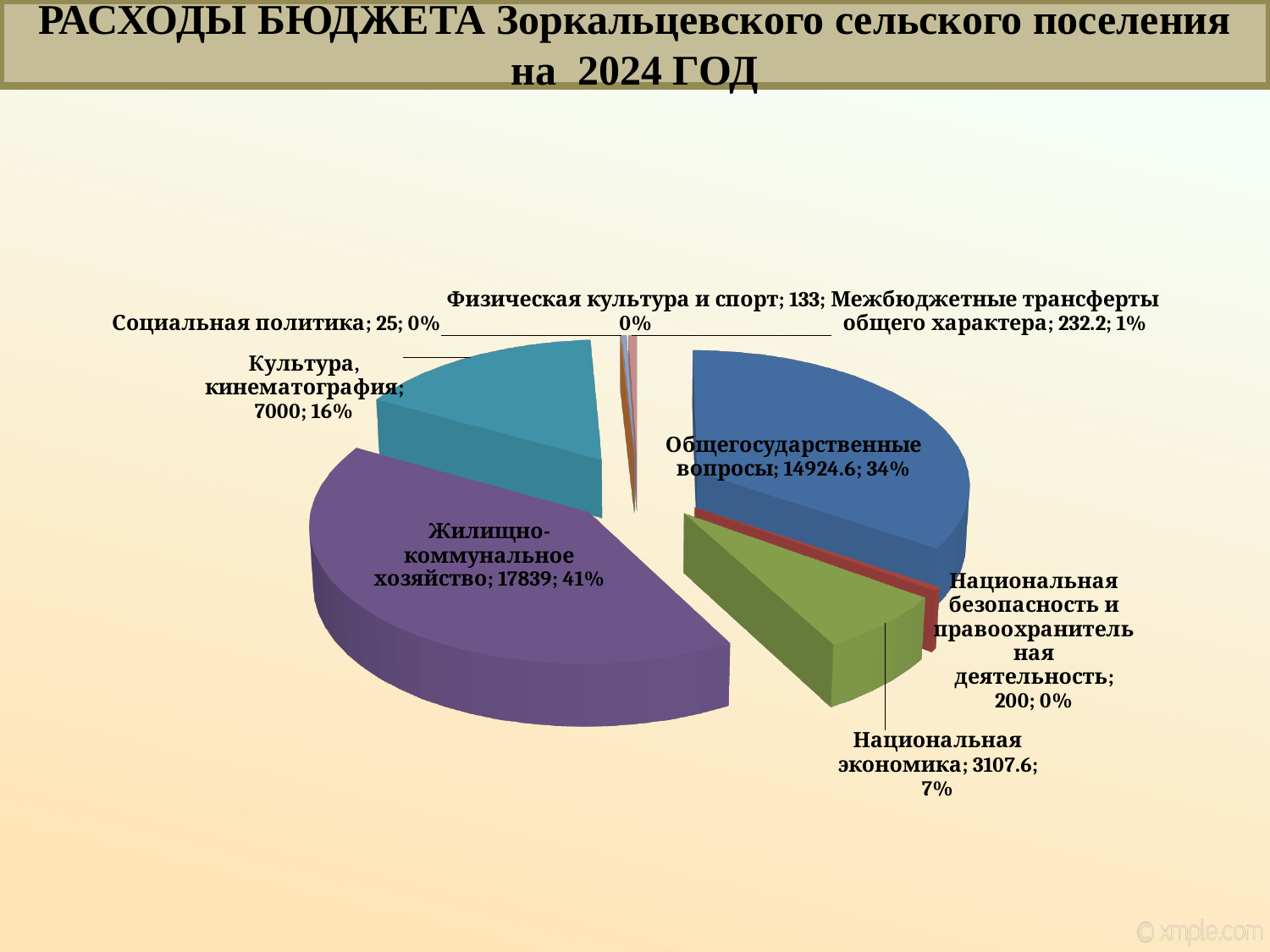
What is the title of the slide? РАСХОДЫ БЮДЖЕТА Зоркальцевского сельского поселения на 2024 ГОД What share of the pie does Культура, кинематография take? 16% What is the value for Межбюджетные трансферты общего характера? 232.2 What is the value for Жилищно-коммунальное хозяйство? 17839 Which category has the smallest value? Социальная политика What share of the pie does Национальная экономика take? 7% Which category has the largest slice? Жилищно-коммунальное хозяйство What is the difference between the values for Жилищно-коммунальное хозяйство and Общегосударственные вопросы? 2914.4 What is the value for Общегосударственные вопросы? 14924.6 Which is larger: the value for Культура, кинематография or the value for Национальная экономика? Культура, кинематография What kind of chart is shown on the slide? pie chart How many categories (slices) does the pie chart show? 8